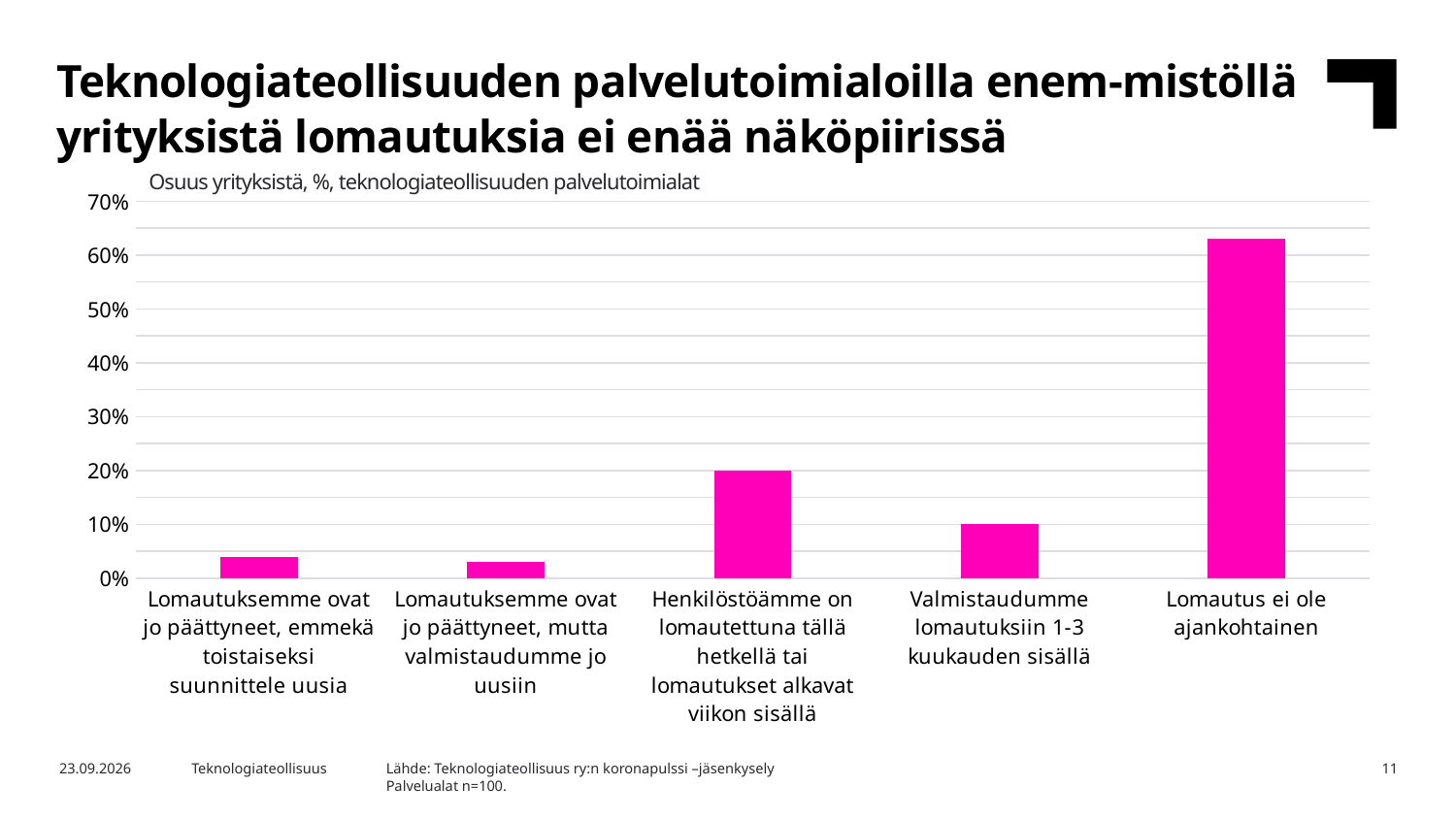
How many categories are shown on the x axis of the chart? 5 Is the value for "Henkilöstöämme on lomautettuna tällä hetkellä tai lomautukset alkavat viikon sisällä" greater or less than 30%? less Is the value for "Lomautuksemme ovat jo päättyneet, emmekä toistaiseksi suunnittele uusia" greater or less than 10%? less Which is larger: the value for "Lomautus ei ole ajankohtainen" or the value for "Valmistaudumme lomautuksiin 1-3 kuukauden sisällä"? Lomautus ei ole ajankohtainen What is the subtitle printed above the chart? Osuus yrityksistä, %, teknologiateollisuuden palvelutoimialat What kind of chart is shown on the slide? Bar chart Is the value for "Lomautuksemme ovat jo päättyneet, mutta valmistaudumme jo uusiin" greater or less than 10%? less What is the highest value shown on the y axis of the chart? 70% Which is larger: the value for "Henkilöstöämme on lomautettuna tällä hetkellä tai lomautukset alkavat viikon sisällä" or the value for "Valmistaudumme lomautuksiin 1-3 kuukauden sisällä"? Henkilöstöämme on lomautettuna tällä hetkellä tai lomautukset alkavat viikon sisällä Which category has the highest value in the chart? Lomautus ei ole ajankohtainen